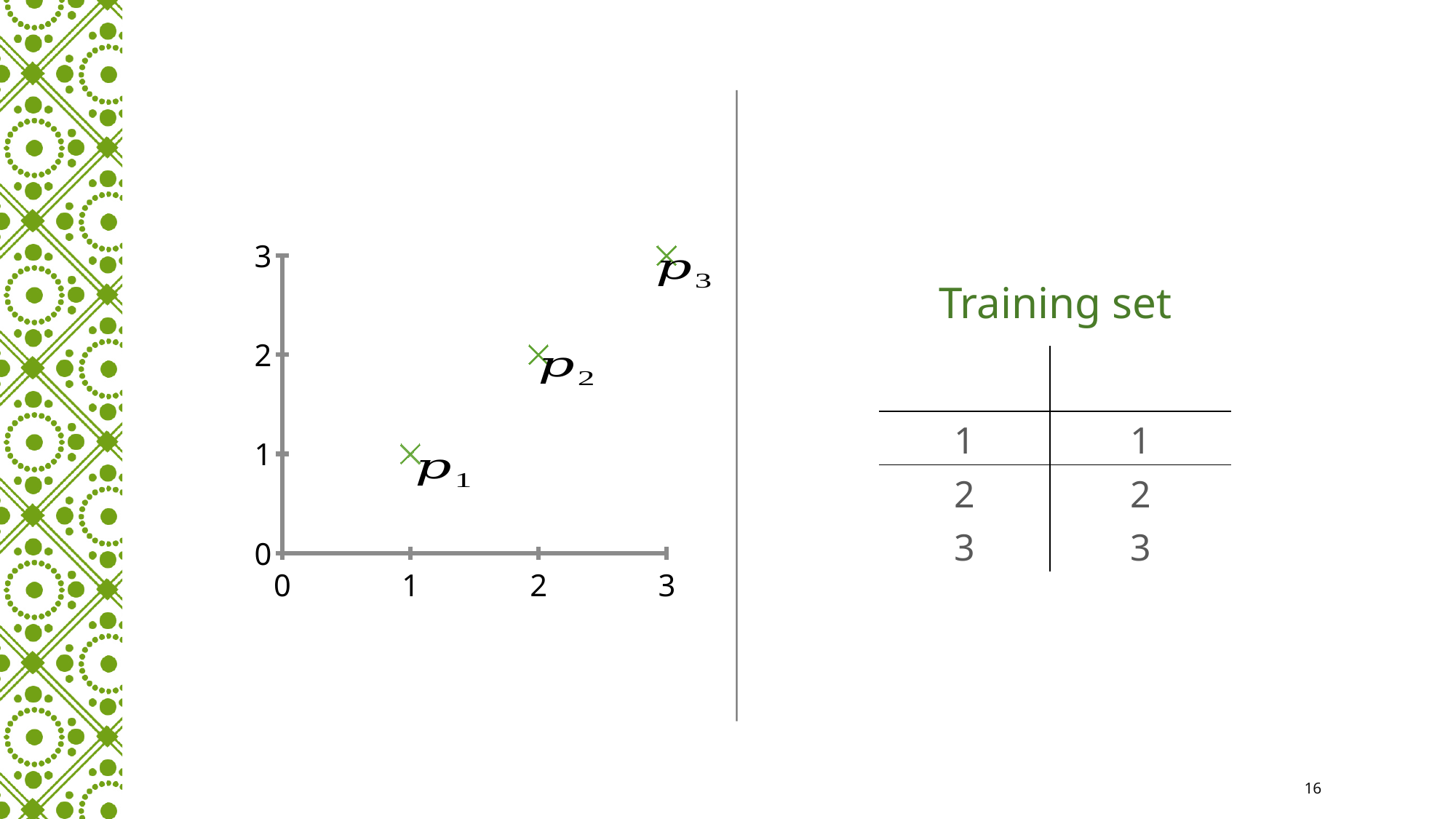
Which point has a larger y value, p1 or p2? p2 What is the x-axis value of point p1? 1 What is the y-axis value of point p2? 2 What kind of chart is shown on the left of the slide? scatter plot What is the highest tick value shown on the x axis? 3 What is the y-axis value of point p3? 3 Is the y value of p3 greater or less than 2? greater How many data points are plotted on the chart? 3 Which point has the lowest y value? p1 Do the y values of the points rise or fall as x increases? rise What is the difference between the y value of p3 and the y value of p1? 2 Which point has the highest y value? p3